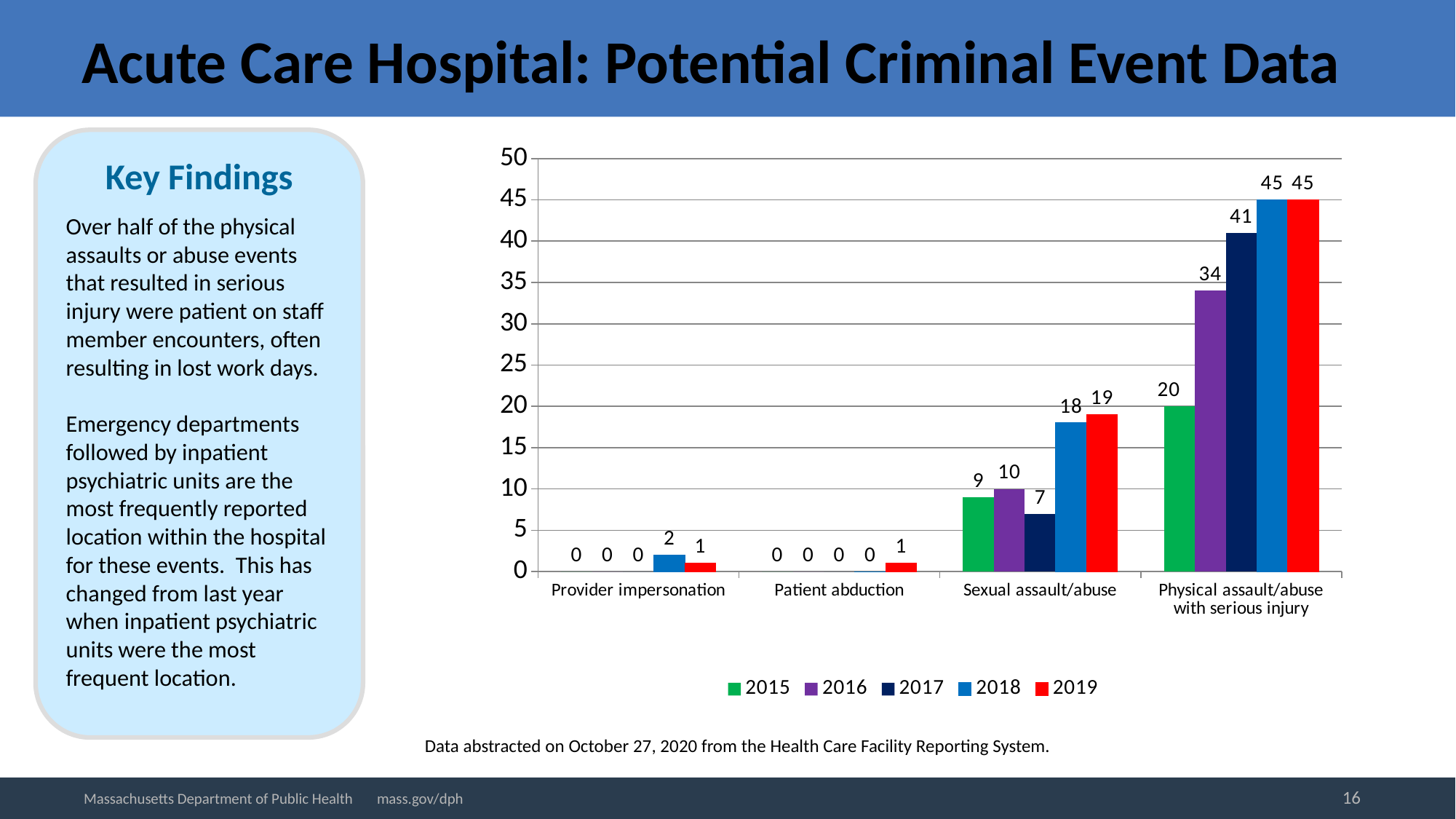
What is the value for Provider impersonation in 2018? 2 Which colour represents 2019 in the legend? Red What is the value for Physical assault/abuse with serious injury in 2017? 41 What is the value for Sexual assault/abuse in 2019? 19 Which year has the lowest value for Sexual assault/abuse? 2017 How many categories are shown on the x axis? 4 How many series does the legend list? 5 Which is larger for Sexual assault/abuse: the 2016 value or the 2018 value? 2018 What is the value for Patient abduction in 2019? 1 What kind of chart is shown on the slide? Bar chart What is the difference between the 2016 and 2015 values for Physical assault/abuse with serious injury? 14 Which category has the highest value in 2016? Physical assault/abuse with serious injury